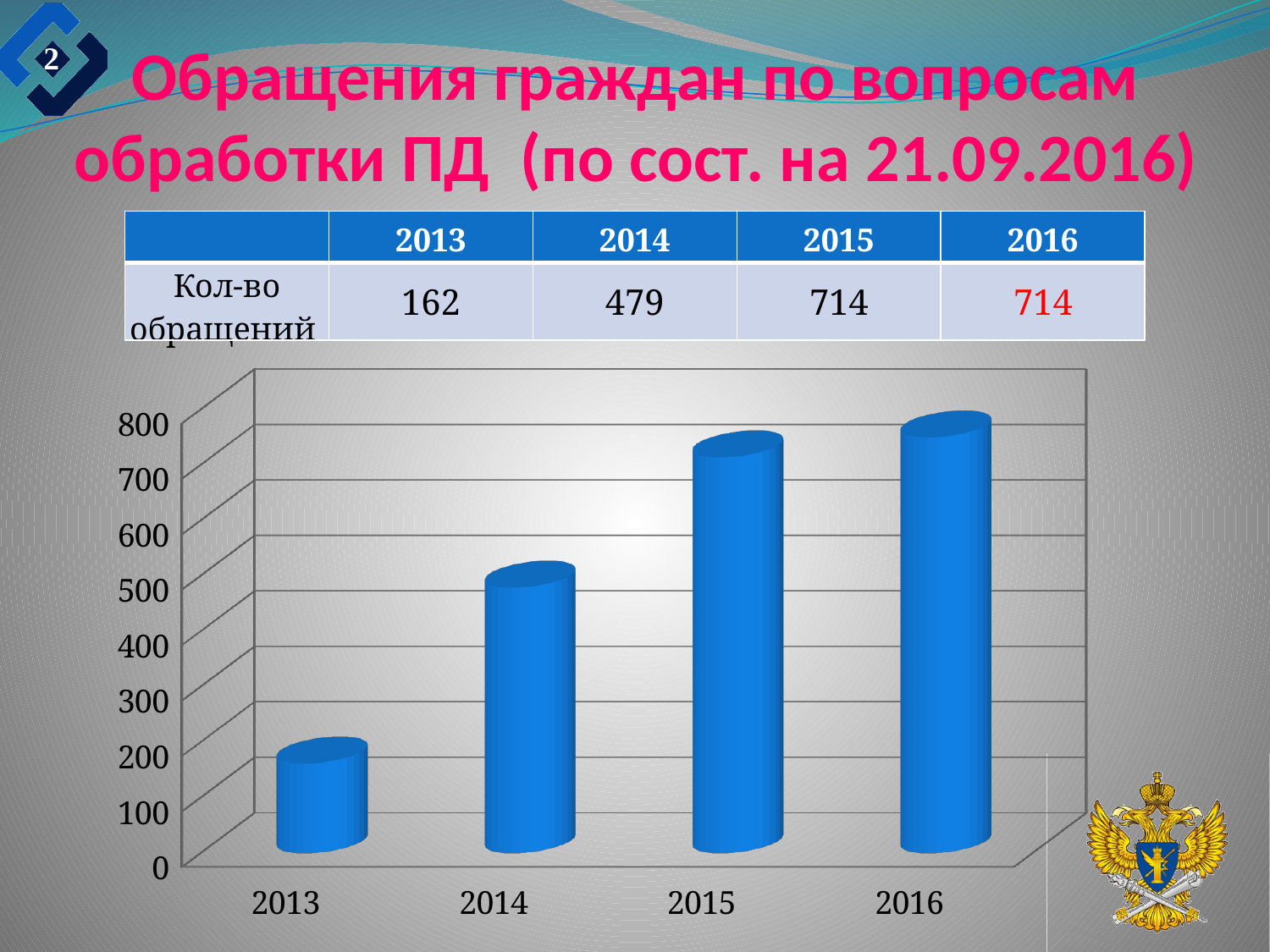
Is the value for 2013 in the chart greater or less than 200? less What kind of chart is shown on the slide? bar chart Do the values in the chart rise or fall from 2013 to 2016? rise Which year has the lowest bar in the chart? 2013 According to the table above the chart, how many обращений were there in 2014? 479 Is the value for 2015 in the chart greater or less than 600? greater Is the value for 2014 in the chart greater or less than 400? greater Using the table values, what is the difference between the number of обращений in 2014 and in 2013? 317 According to the table above the chart, how many обращений were there in 2013? 162 How many years (categories) are shown on the x axis of the chart? 4 Which is larger in the chart, the value for 2014 or the value for 2015? 2015